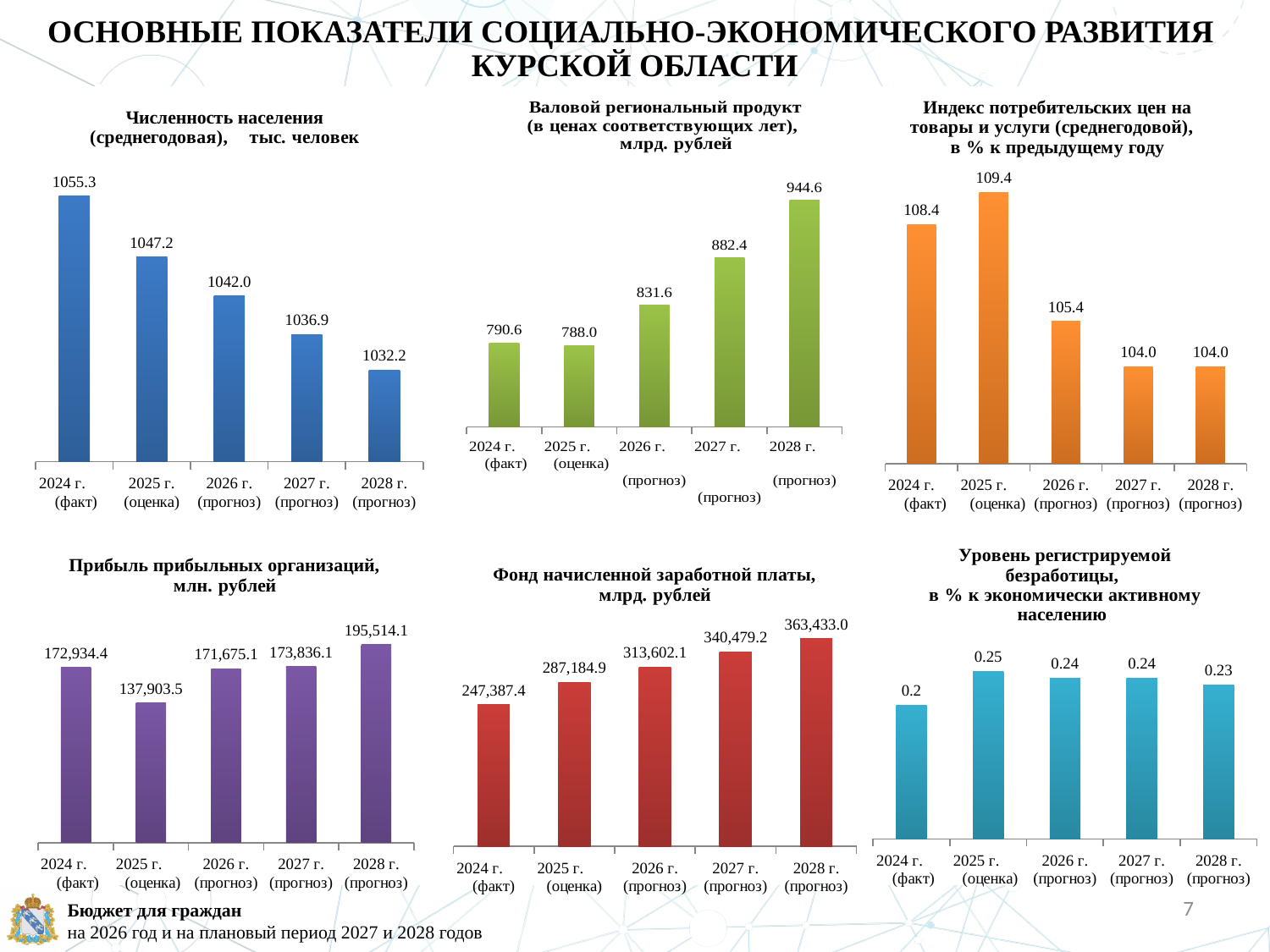
On the chart 'Валовой региональный продукт', which year has the highest value? 2028 г. (прогноз) On the chart 'Индекс потребительских цен на товары и услуги', what is the value for 2025 г. (оценка)? 109.4 On the chart 'Валовой региональный продукт', what is the value for 2026 г. (прогноз)? 831.6 On the chart 'Уровень регистрируемой безработицы', what is the value for 2024 г. (факт)? 0.2 On the chart 'Фонд начисленной заработной платы, млрд. рублей', which is larger: the value for 2026 г. or the value for 2027 г.? 2027 г. On the chart 'Прибыль прибыльных организаций, млн. рублей', what is the value for 2028 г. (прогноз)? 195,514.1 On the chart 'Численность населения (среднегодовая), тыс. человек', what is the value for 2024 г. (факт)? 1055.3 On the chart 'Численность населения (среднегодовая), тыс. человек', what is the difference between the 2024 г. (факт) and 2028 г. (прогноз) values? 23.1 On the chart 'Прибыль прибыльных организаций, млн. рублей', which year has the lowest value? 2025 г. (оценка) On the chart 'Индекс потребительских цен на товары и услуги', how many years (bars) are shown? 5 On the chart 'Численность населения (среднегодовая), тыс. человек', do the values rise or fall from 2024 г. to 2028 г.? fall On the chart 'Валовой региональный продукт', which year has the lowest value? 2025 г. (оценка)